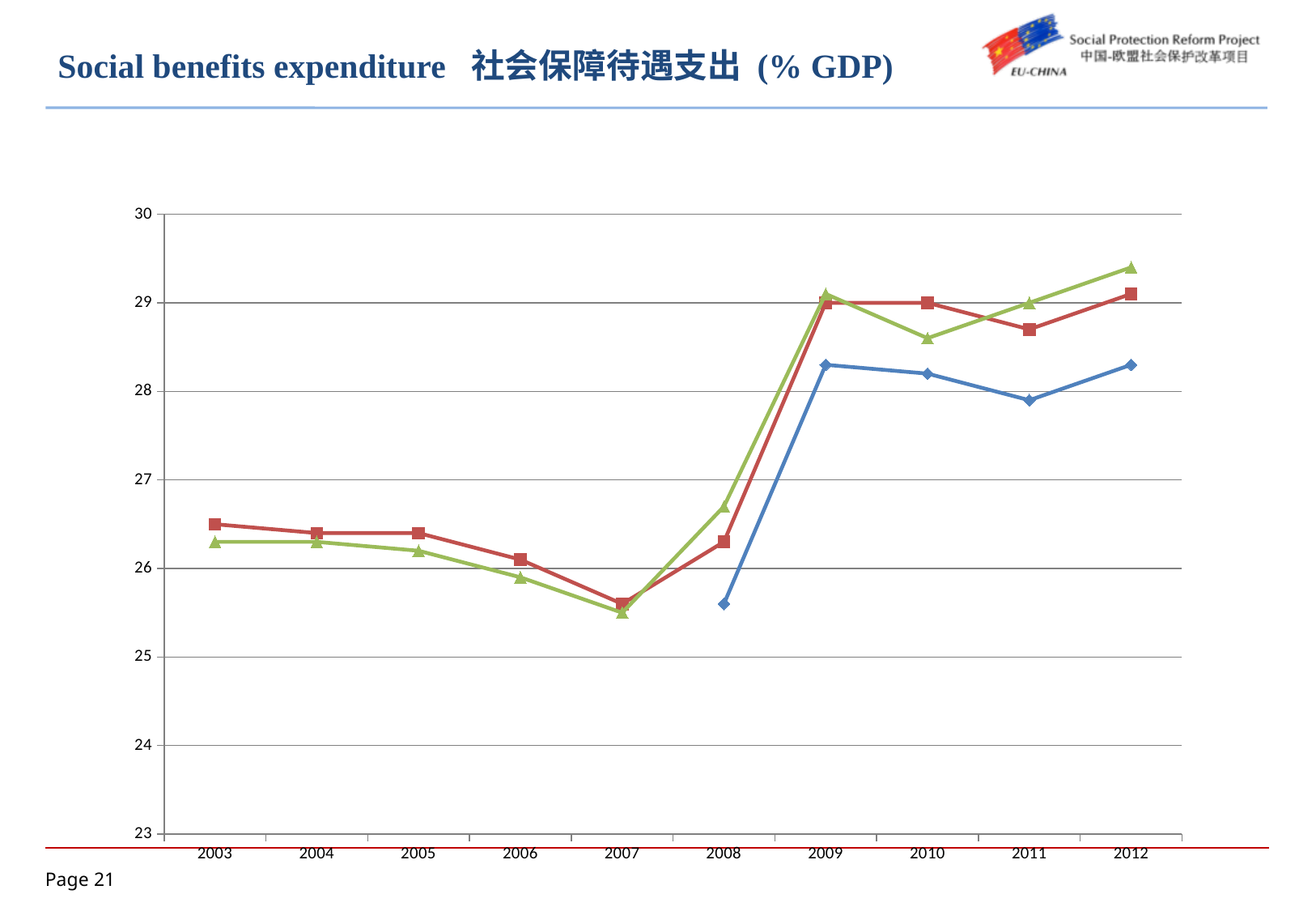
How many years are shown on the x axis of the chart? 10 Is the value of the green line (triangle markers) in 2012 greater or less than 29? greater Is the value of the blue line (diamond markers) in 2011 greater or less than 28? less Is the value of the red line (square markers) in 2003 greater or less than 26? greater Does the red line (square markers) rise or fall between 2003 and 2007? fall What is the first year shown on the x axis? 2003 In 2012, which line is higher: the green line (triangle markers) or the blue line (diamond markers)? green line What kind of chart is shown on the slide? line chart Does the green line (triangle markers) rise or fall between 2007 and 2009? rise In which year does the blue line (diamond markers) reach its lowest value? 2008